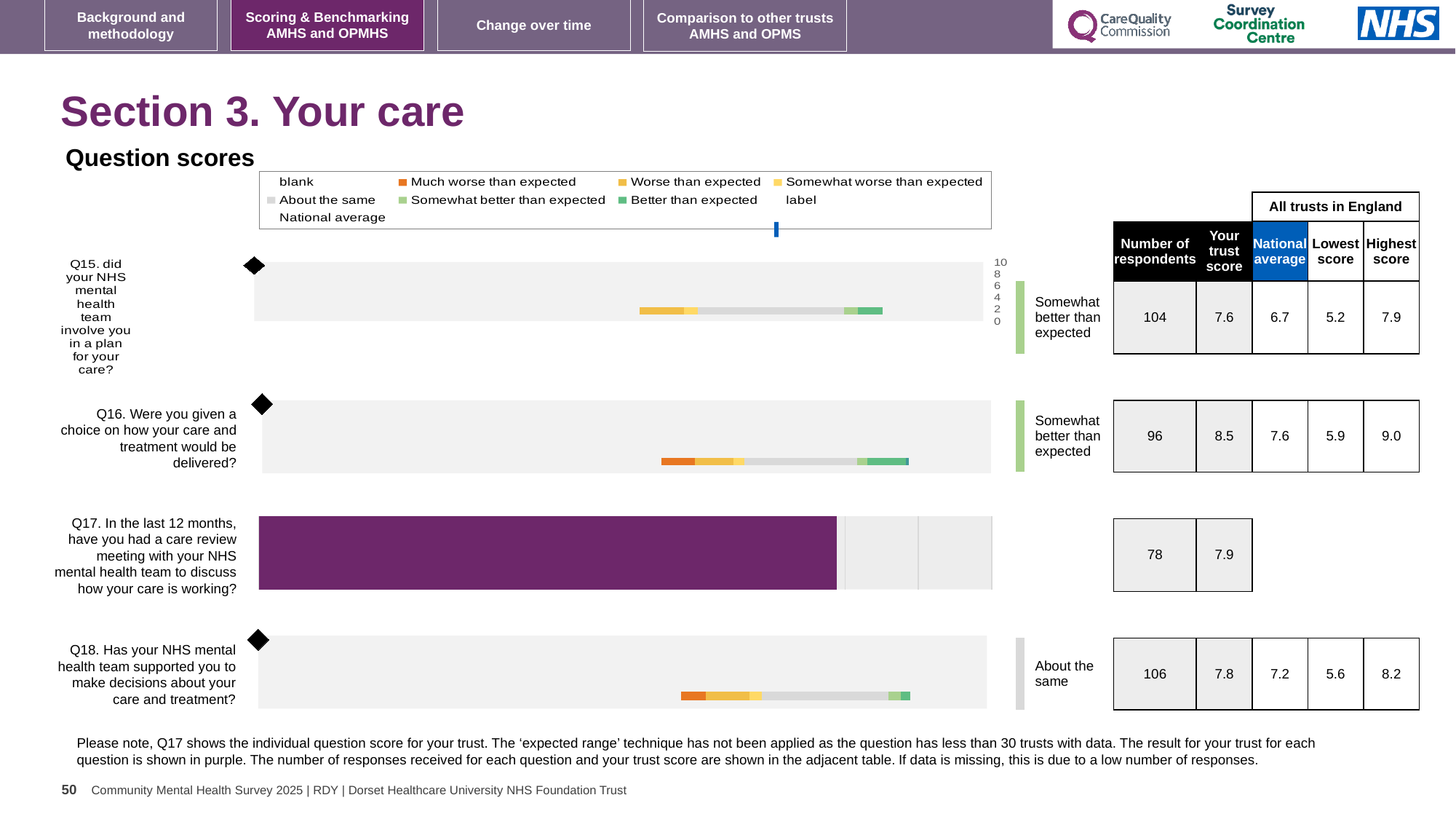
What kind of chart is used to show the question scores on this slide? bar chart What is the national average score for Q15? 6.7 How many questions are plotted in the question scores chart? 4 Which question has the lowest trust score? Q15 By how much does the trust score for Q16 exceed the national average for Q16? 0.9 What is the trust score for Q16 (choice on how care and treatment would be delivered)? 8.5 How many respondents answered Q18? 106 What is the difference between the highest score and the lowest score for Q15? 2.7 Which question has the highest trust score? Q16 What is the highest score among all trusts in England for Q16? 9.0 Which question's bar is shown in purple rather than with the expected range bands? Q17 For Q18, which is larger: the trust score or the national average? the trust score